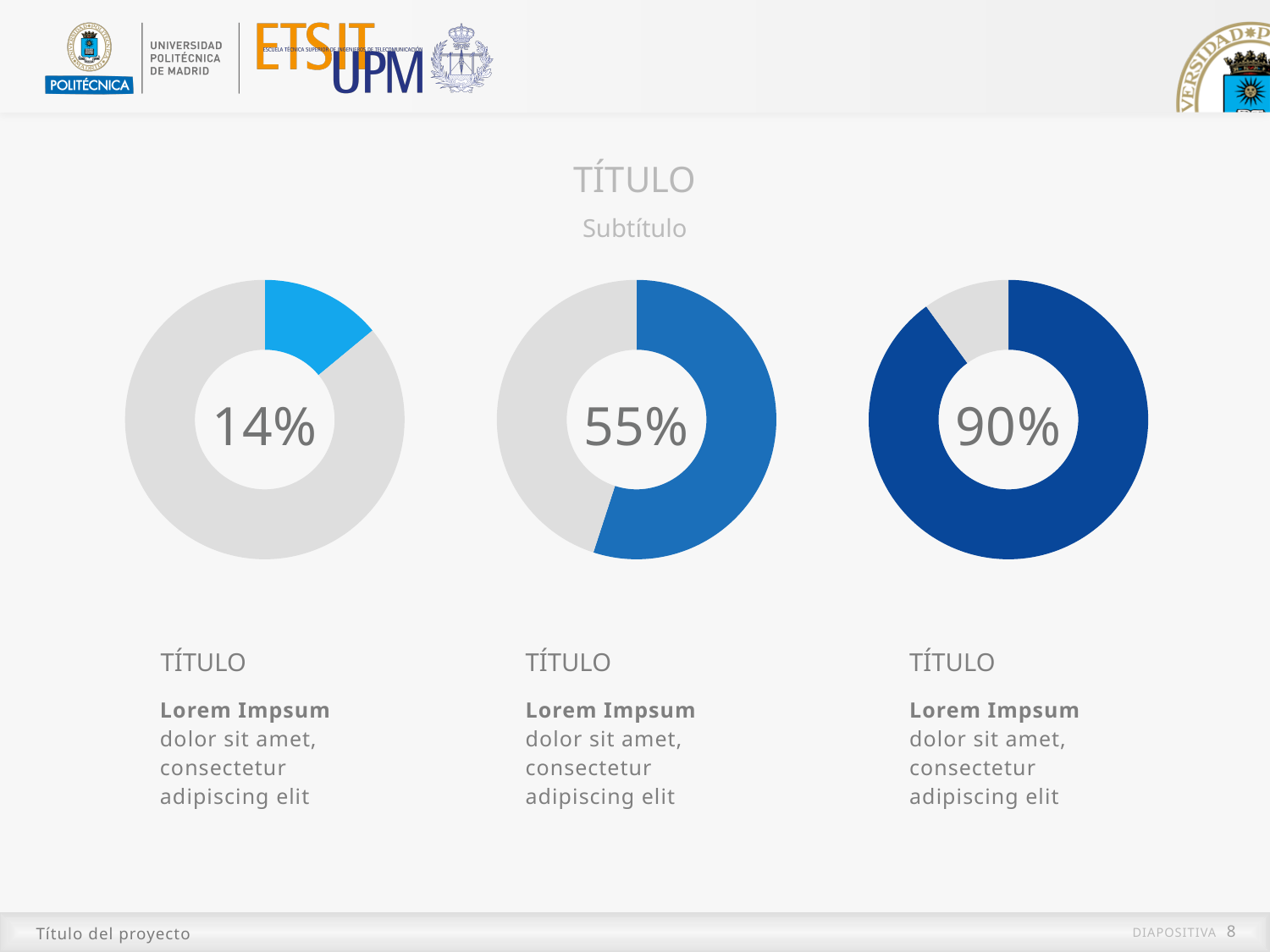
What kind of chart is used to display the percentages on the slide? Donut chart What share of the right donut chart is filled with the dark blue colour? 90% What is the difference between the percentage in the middle donut chart and the percentage in the left donut chart? 41% What percentage is shown in the centre of the middle donut chart? 55% Which of the three donut charts shows the highest percentage? The right chart (90%) Is the percentage shown in the middle donut chart greater or less than 50%? greater Which shows a larger percentage, the middle donut chart or the right donut chart? The right chart How many donut charts are on the slide? 3 What percentage is shown in the centre of the right donut chart? 90% What percentage is shown in the centre of the left donut chart? 14% What is the difference between the percentage in the right donut chart and the percentage in the left donut chart? 76% Which of the three donut charts shows the lowest percentage? The left chart (14%)